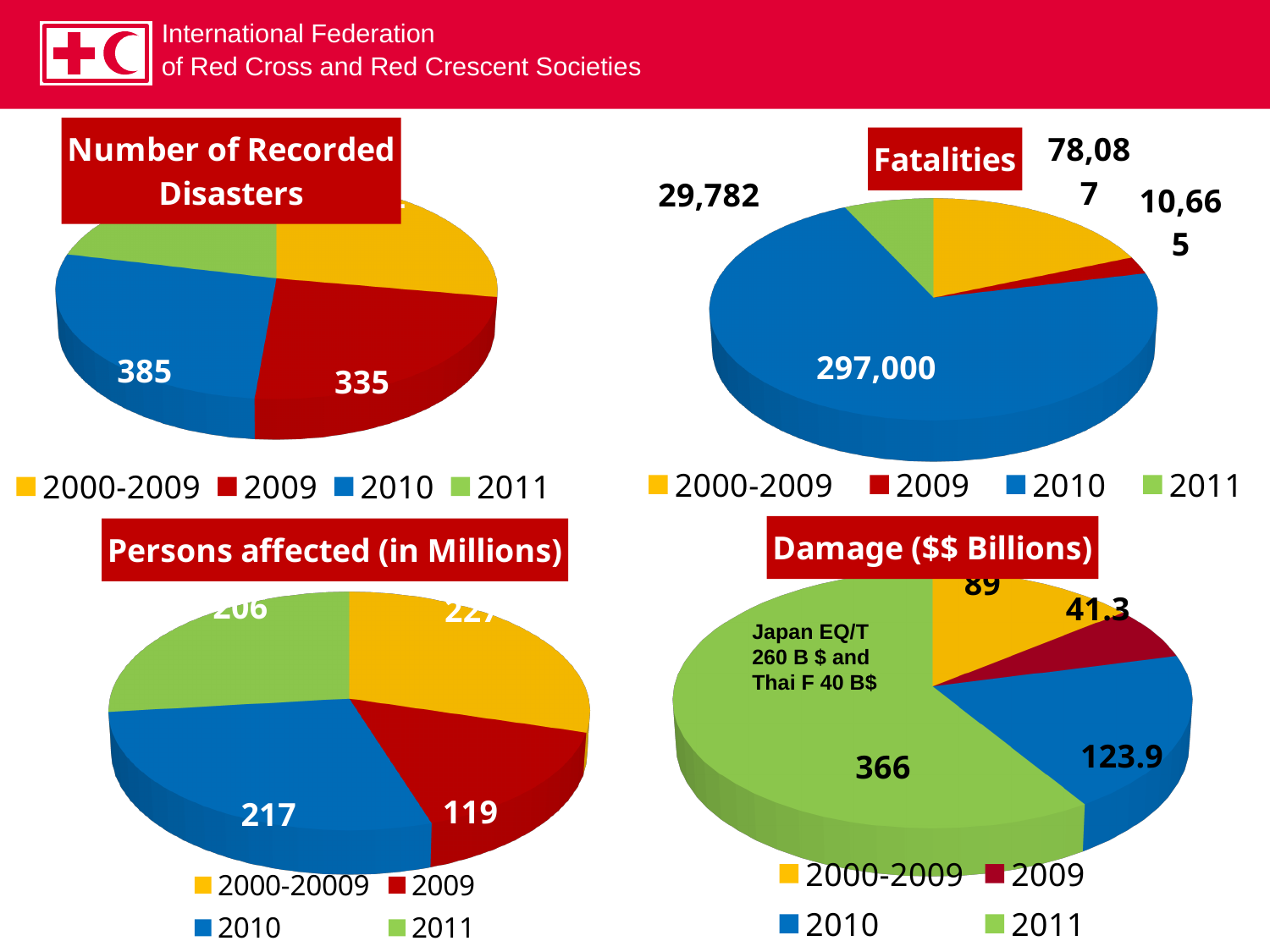
In the Persons affected (in Millions) chart, what is the value for 2009? 119 In the Fatalities chart, which category has the lowest value? 2009 In the Fatalities chart, what is the value for 2009? 10,665 How many entries does the legend of the Fatalities chart list? 4 In the Fatalities chart, what is the value for 2010? 297,000 In the Number of Recorded Disasters chart, what is the value for 2010? 385 In the Damage ($$ Billions) chart, what is the value for 2011? 366 In the Damage ($$ Billions) chart, what is the difference between the 2010 value and the 2009 value? 82.6 In the Number of Recorded Disasters chart, which is larger, the value for 2010 or the value for 2009? 2010 What type of chart is the Damage ($$ Billions) chart? Pie chart In the Fatalities chart, what is the difference between the 2000-2009 value and the 2011 value? 48,305 In the Fatalities chart, which year has the highest number of fatalities? 2010